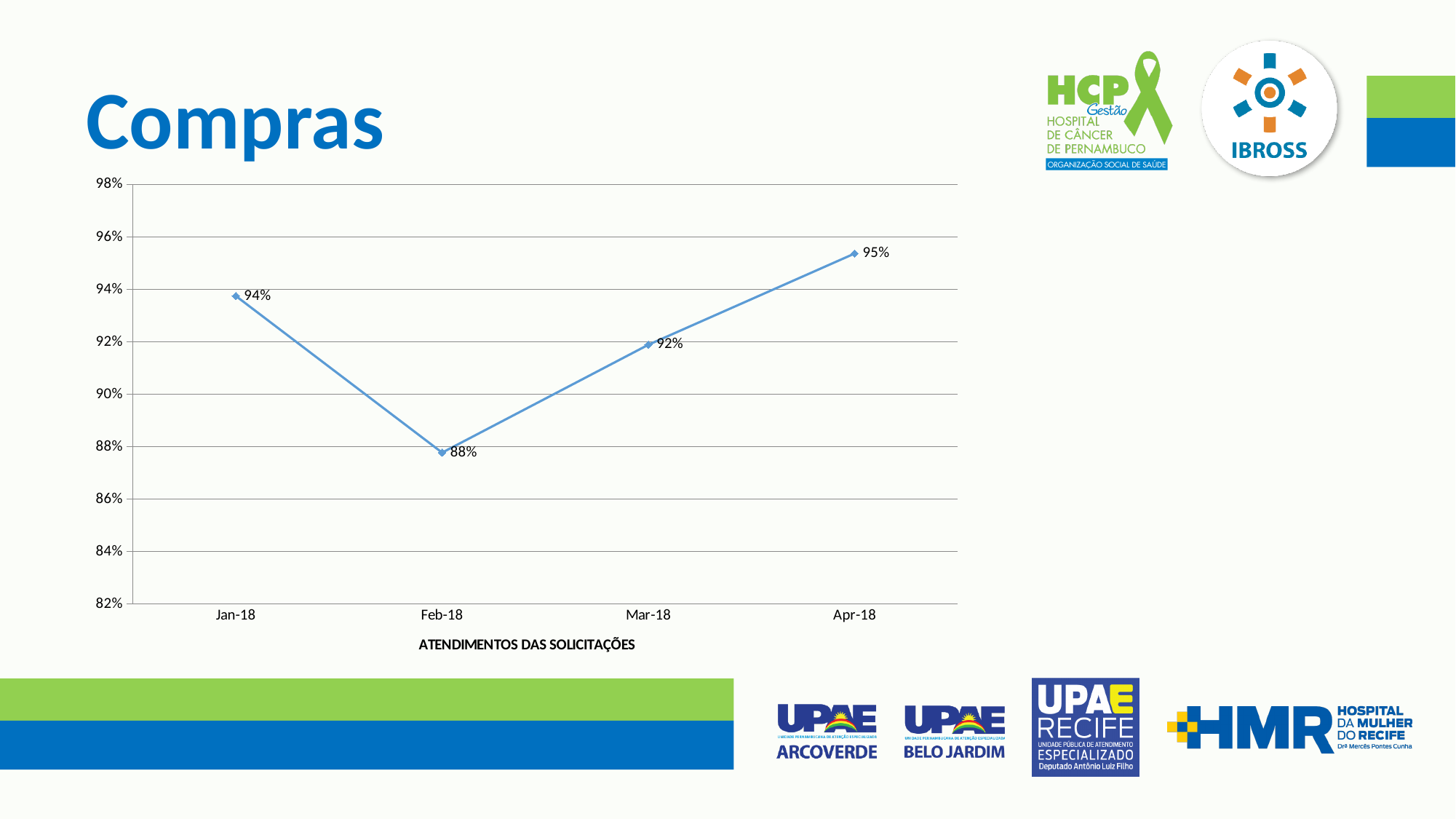
Is the value for Feb-18 greater or less than 90%? less Which month has the highest value? Apr-18 What kind of chart is shown on the slide? line chart What is the difference between the values for Apr-18 and Feb-18? 7% Which month has the lowest value? Feb-18 What is the value for Mar-18? 92% Which is larger, the value for Jan-18 or the value for Mar-18? Jan-18 What is the value for Jan-18? 94% What is the value for Apr-18? 95% What is the value for Feb-18? 88% What is the label shown below the x axis of the chart? ATENDIMENTOS DAS SOLICITAÇÕES How many months are plotted on the chart? 4